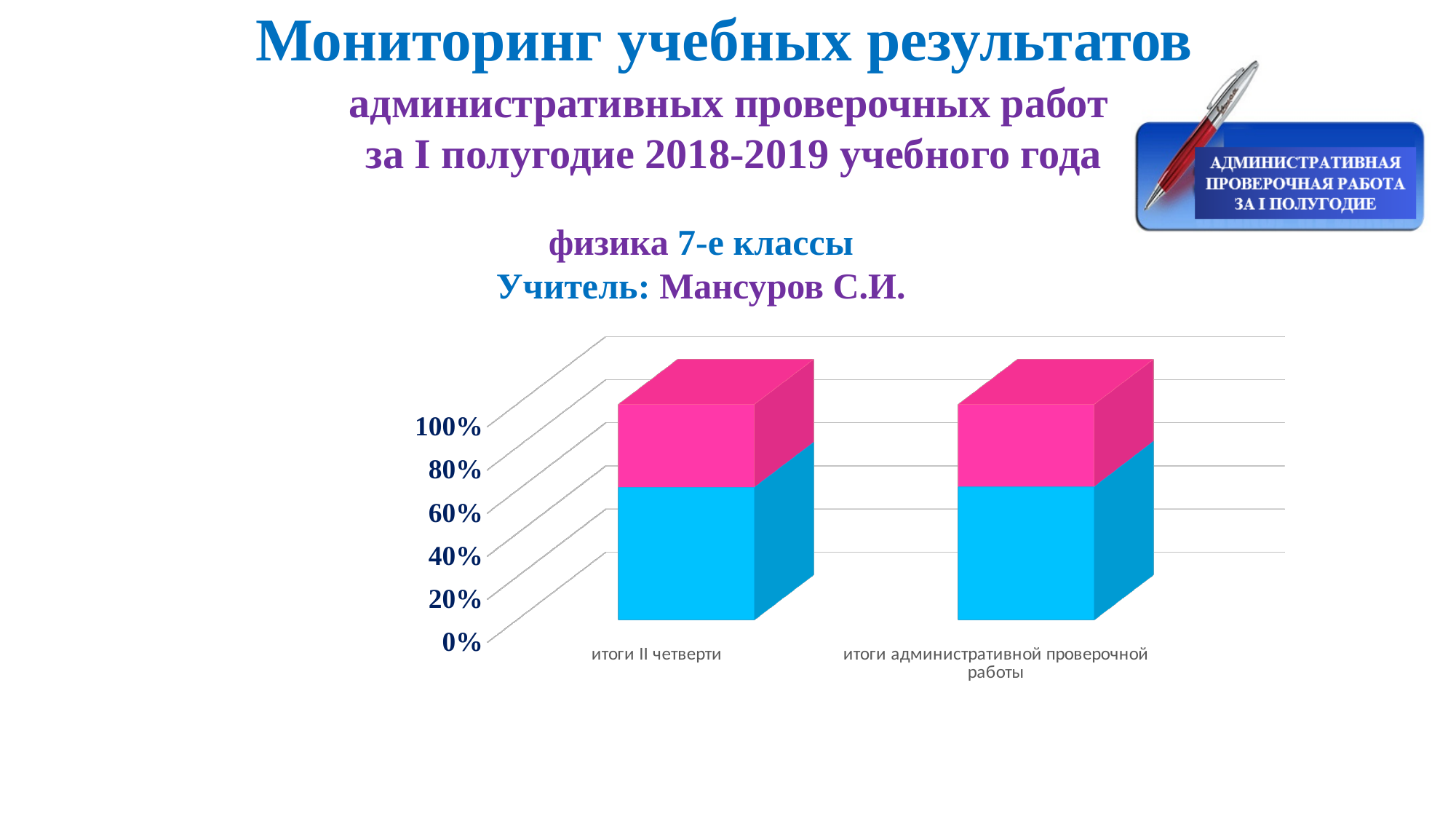
What is the label of the second (right) category on the x axis? итоги административной проверочной работы How many coloured segments does each stacked bar contain? 2 What is the highest value shown on the y axis of the chart? 100% Is the blue segment of the bar for 'итоги II четверти' greater or less than 80%? less What is the label of the first (left) category on the x axis? итоги II четверти How many categories are shown on the x axis of the chart? 2 What kind of chart is shown on the slide? stacked bar chart Is the blue segment of the bar for 'итоги II четверти' greater or less than 40%? greater Is the blue segment of the bar for 'итоги административной проверочной работы' greater or less than 80%? less